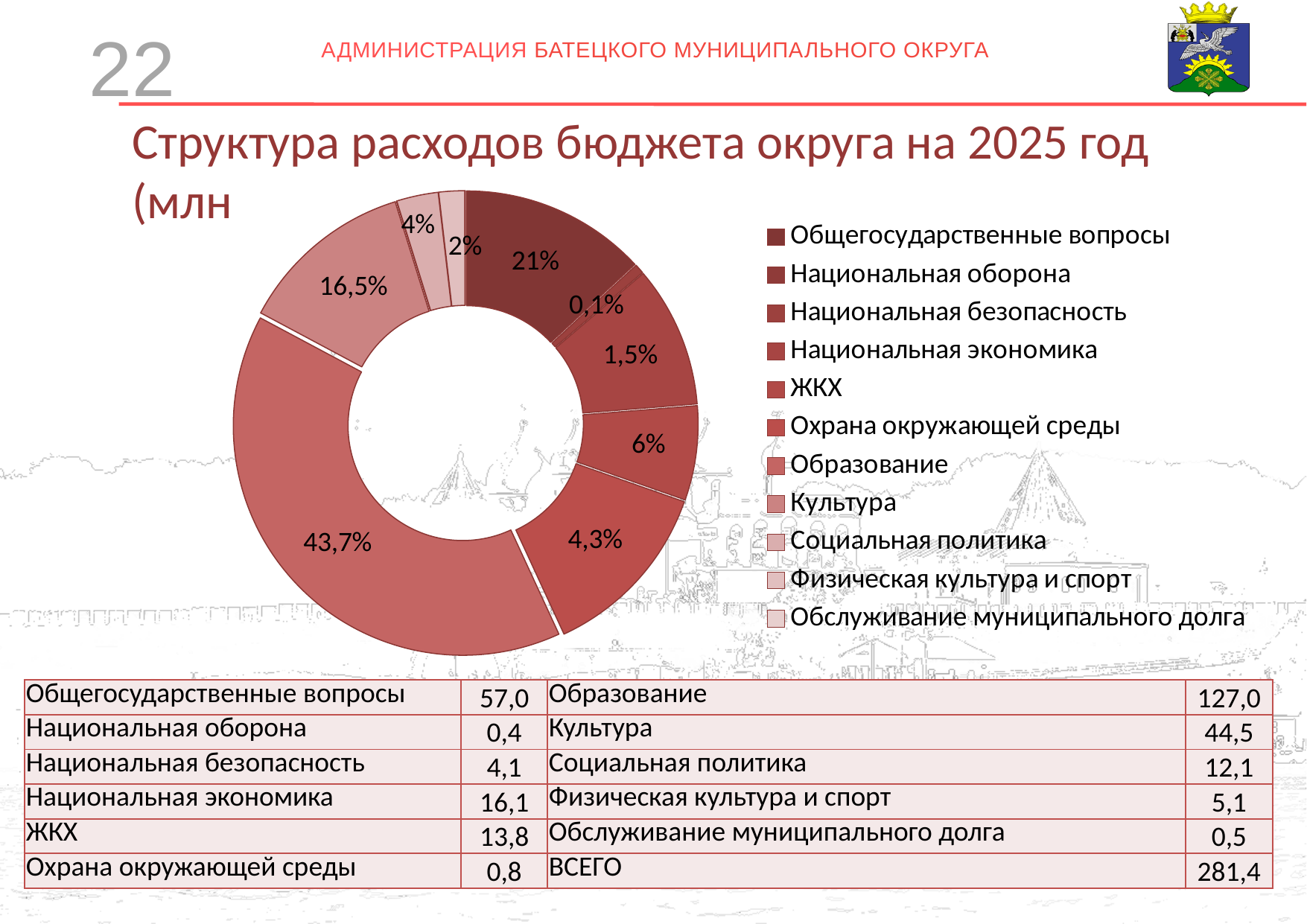
What share of the chart does Национальная оборона take? 0,1% What is the difference in percentage points between the Образование slice and the Общегосударственные вопросы slice? 22,7% What share of the chart does Культура take? 16,5% What share of the chart does Национальная экономика take? 6% What share of the chart does Социальная политика take? 4% Which category has the largest slice in the chart? Образование What is the first entry listed in the chart legend? Общегосударственные вопросы What share of the chart does Образование take? 43,7% How many entries does the chart legend list? 11 What share of the chart does Общегосударственные вопросы take? 21% Which is larger in the chart: Культура or Общегосударственные вопросы? Общегосударственные вопросы What kind of chart is shown on the slide? Doughnut (pie) chart